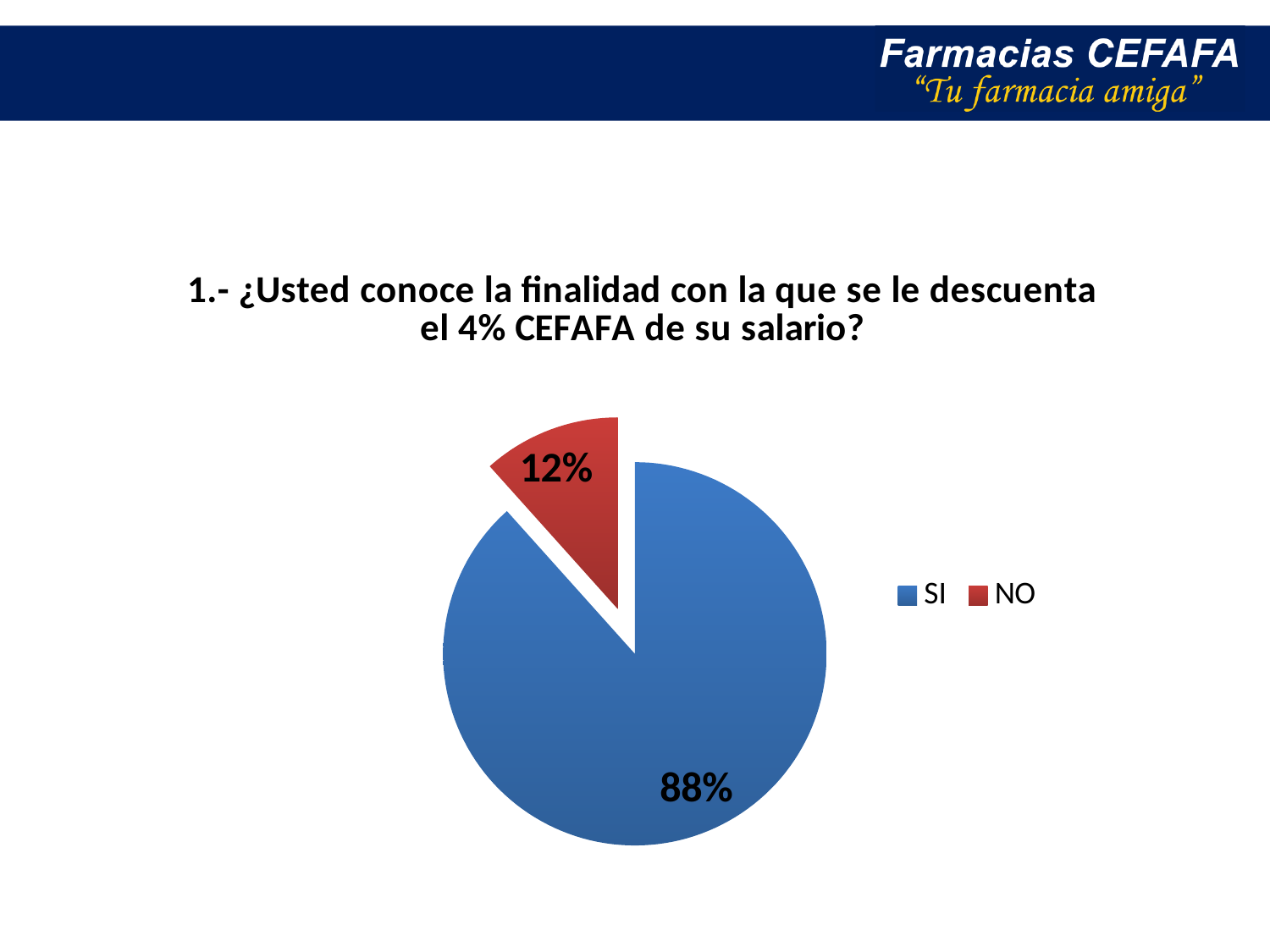
What share of the pie does the SI slice represent? 88% How many entries does the legend list? 2 Which category has the smallest slice of the pie? NO What kind of chart is shown on the slide? pie chart How many categories does the pie chart have? 2 Which is larger, the SI slice or the NO slice? SI What colour is the NO slice? red What is the difference in percentage points between the SI and NO slices? 76 What colour is the SI slice? blue Which category has the largest slice of the pie? SI What share of the pie does the NO slice represent? 12%